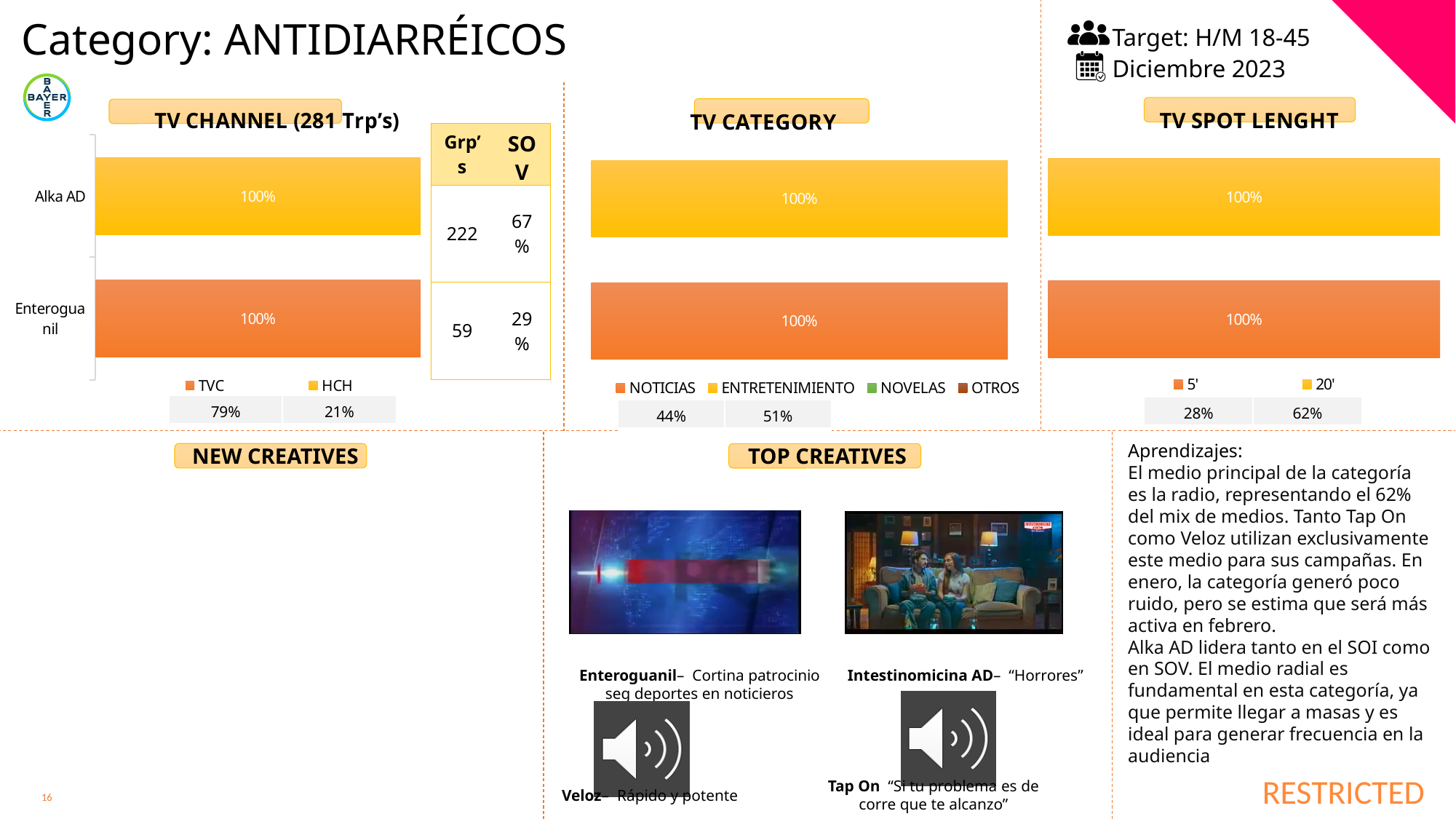
How many series does the legend of the TV CATEGORY chart list? 4 Which series are listed in the legend of the TV SPOT LENGHT chart? 5' and 20' How many series does the legend of the TV CHANNEL (281 Trp's) chart list? 2 In the TV CATEGORY chart, what value is labelled on the top bar? 100% In the table next to the TV CHANNEL chart, what is the difference in Grp's between Alka AD and Enteroguanil? 163 In the TV CHANNEL (281 Trp's) chart, what value is labelled on the Enteroguanil bar? 100% What type of chart is the TV CHANNEL (281 Trp's) chart? bar chart How many categories are shown in the TV CHANNEL (281 Trp's) chart? 2 In the table next to the TV CHANNEL chart, what is the SOV for Enteroguanil? 29% In the table next to the TV CHANNEL chart, what is the Grp's value for Alka AD? 222 In the TV CHANNEL (281 Trp's) chart, what value is labelled on the Alka AD bar? 100% In the TV SPOT LENGHT chart, what value is labelled on the bottom bar? 100%